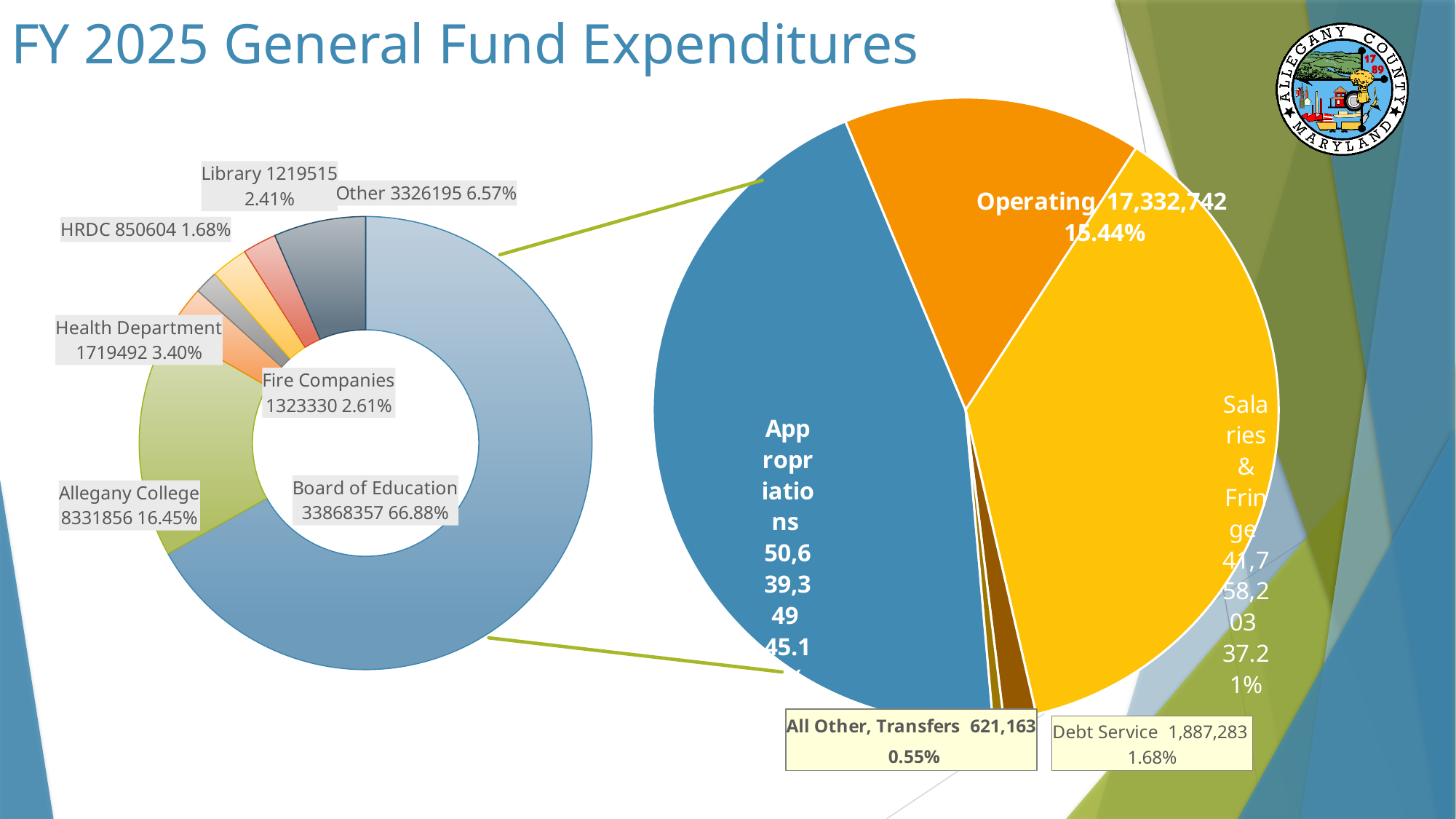
In the donut chart on the left, what is the value shown for Allegany College? 8331856 In the donut chart on the left, which is larger, Health Department or Fire Companies? Health Department In the pie chart on the right, how many categories are shown? 5 In the pie chart on the right, which category has the largest slice? Appropriations In the pie chart on the right, what is the value shown for Operating? 17,332,742 In the pie chart on the right, what is the difference between the Operating value and the Debt Service value? 15,445,459 In the pie chart on the right, what is the value shown for Debt Service? 1,887,283 In the pie chart on the right, which category has the smallest slice? All Other, Transfers In the donut chart on the left, how many categories are shown? 7 In the donut chart on the left, which category has the smallest share? HRDC In the donut chart on the left, what share of the total is Board of Education? 66.88% In the pie chart on the right, what share of the total is Salaries & Fringe? 37.21%